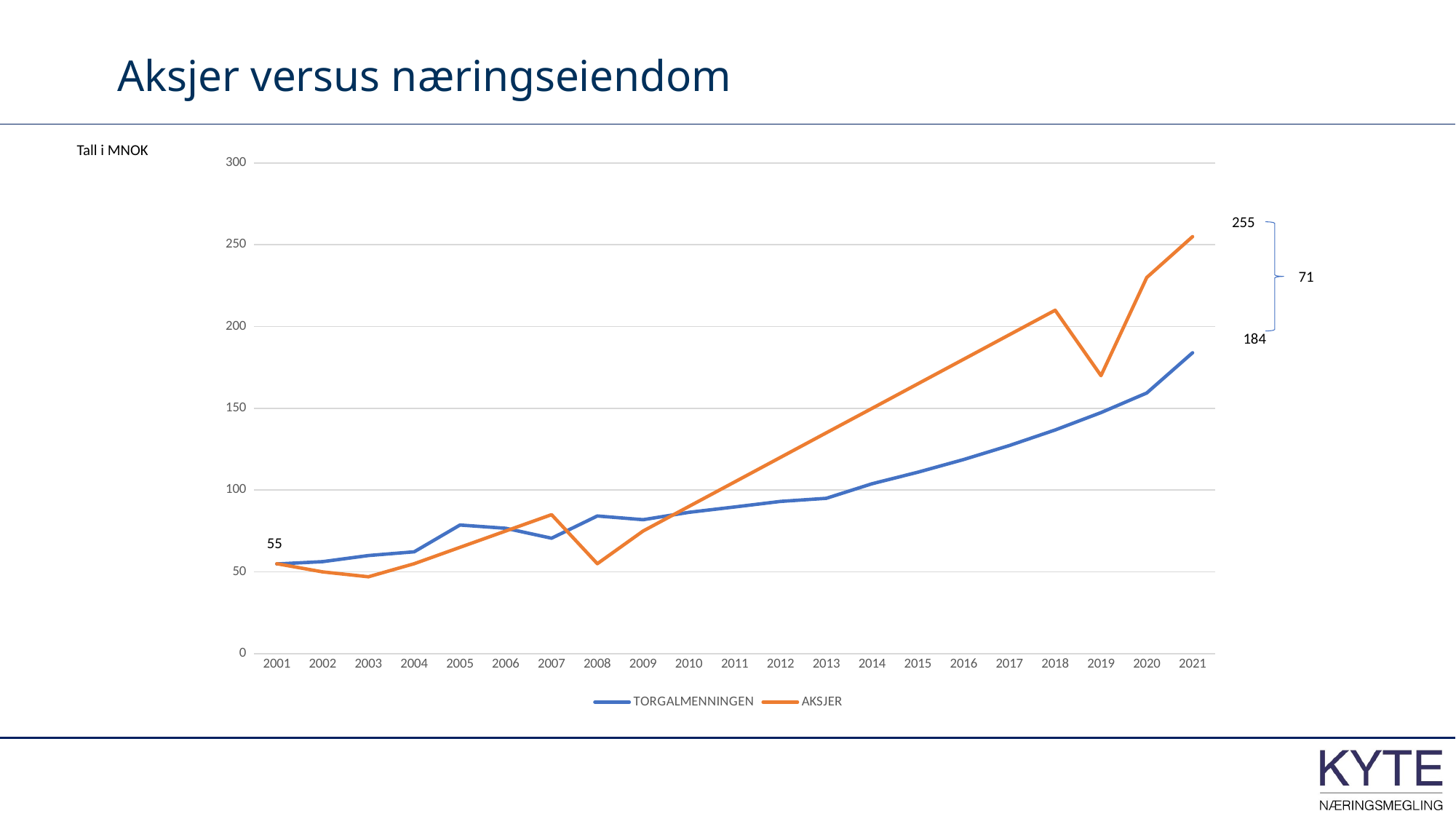
What are the two series named in the legend? TORGALMENNINGEN and AKSJER How many series does the legend list? 2 Does the TORGALMENNINGEN series generally rise or fall from 2001 to 2021? rise What is the starting value shown for 2001? 55 What type of chart is shown on the slide? line chart Which series has the higher value in 2021, AKSJER or TORGALMENNINGEN? AKSJER How many years are shown on the x axis? 21 Is the value for AKSJER in 2019 greater or less than 200? less What is the value of AKSJER in 2021? 255 What is the difference between AKSJER and TORGALMENNINGEN in 2021? 71 Is the value for TORGALMENNINGEN in 2020 greater or less than 150? greater What is the value of TORGALMENNINGEN in 2021? 184